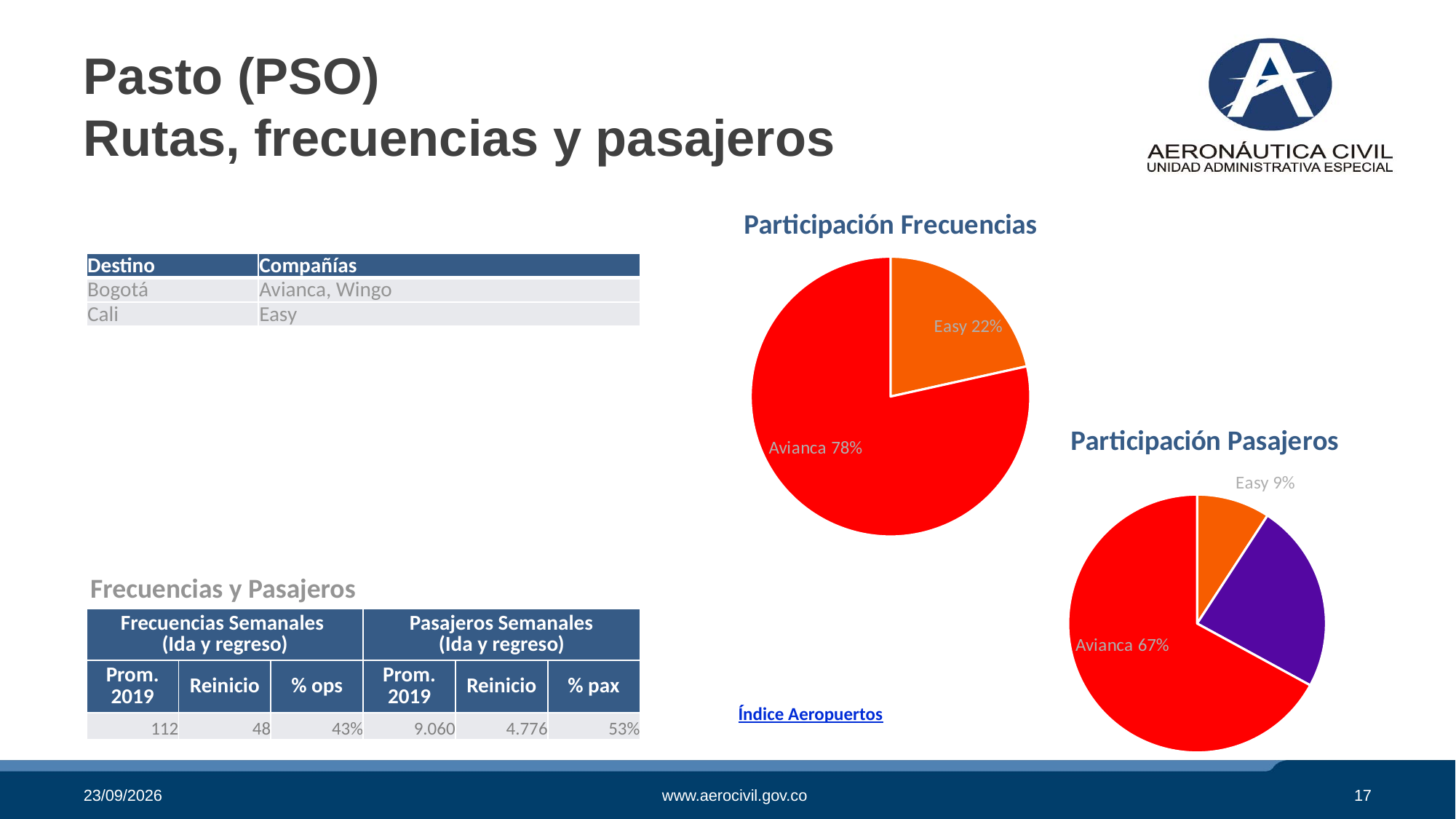
In the 'Participación Frecuencias' chart, what share does Easy have? 22% In the 'Participación Pasajeros' chart, what is the difference between Avianca's share and Easy's share? 58% In the 'Participación Frecuencias' chart, which company has the largest slice? Avianca In the 'Participación Pasajeros' chart, what share does Easy have? 9% In the 'Participación Pasajeros' chart, which labelled company has the smallest slice? Easy What type of chart is 'Participación Frecuencias'? Pie chart In the 'Participación Frecuencias' chart, what is the difference between Avianca's share and Easy's share? 56% How many slices does the 'Participación Frecuencias' pie chart have? 2 How many slices does the 'Participación Pasajeros' pie chart have? 3 Is Easy's share larger in the 'Participación Frecuencias' chart or in the 'Participación Pasajeros' chart? Participación Frecuencias In the 'Participación Frecuencias' chart, what share does Avianca have? 78%